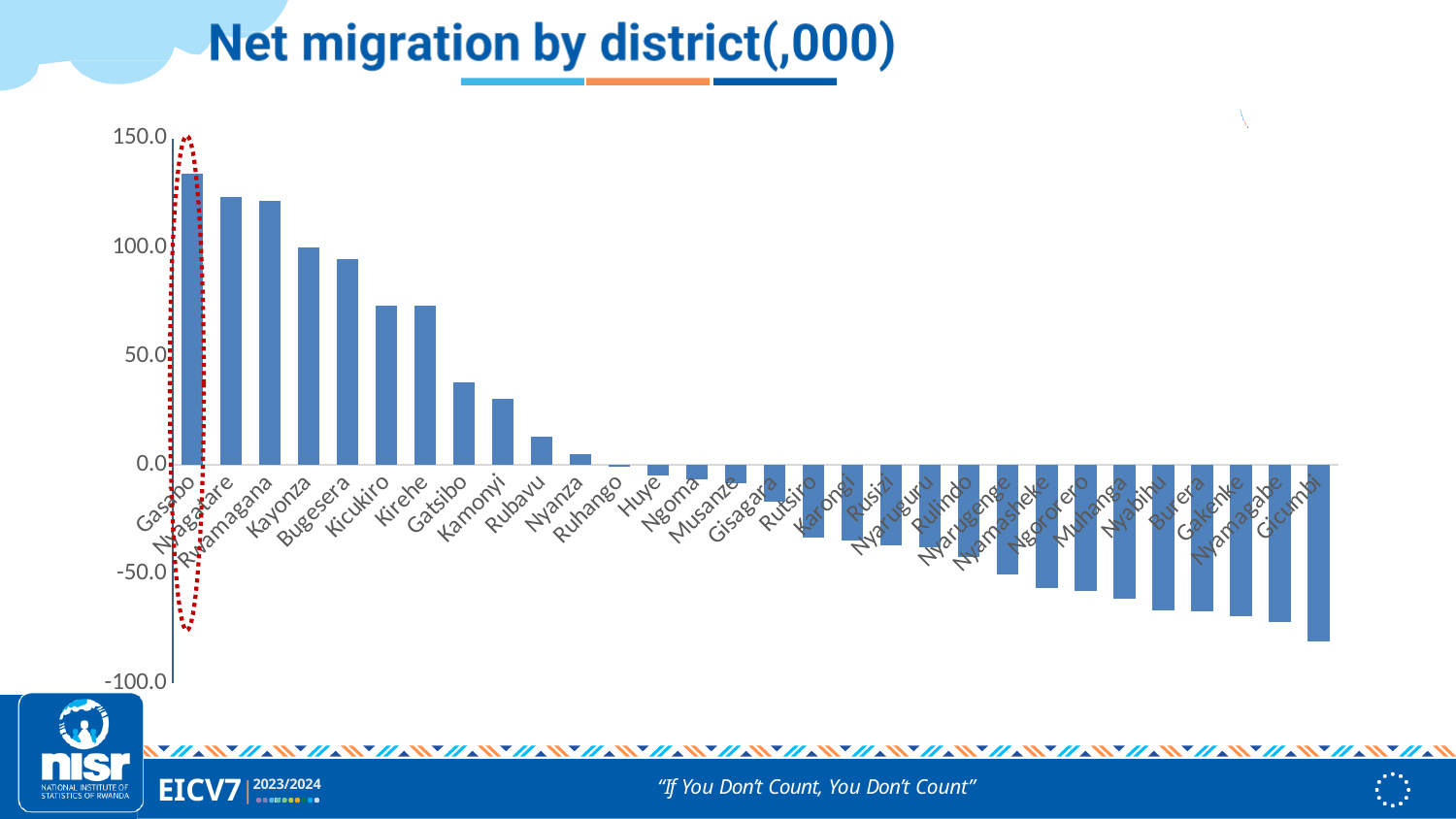
Which has the larger net migration, Gasabo or Nyagatare? Gasabo What kind of chart is shown on the slide? Bar chart How many districts are shown on the x axis? 30 Which district has the lowest net migration? Gicumbi Do the values rise or fall moving from left to right along the x axis? Fall Is the value for Gatsibo greater or less than 50.0? less Is the value for Bugesera greater or less than 100.0? less What is the title of the chart? Net migration by district(,000) Is the value for Gasabo greater or less than 100.0? greater Which district has the highest net migration? Gasabo